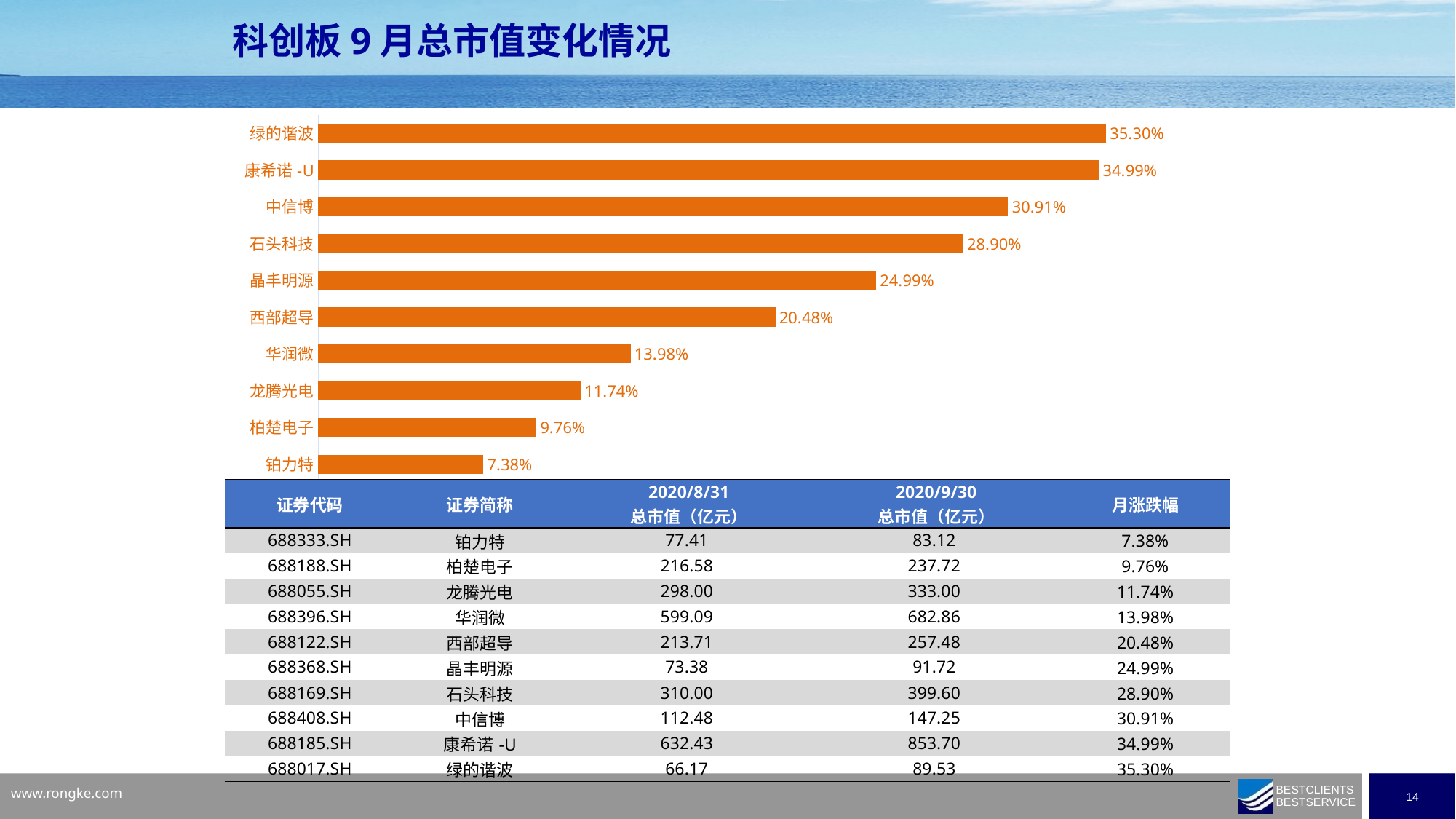
What colour are the bars in the chart? orange Which company has the lowest value in the bar chart? 铂力特 What is the value shown for 西部超导 in the bar chart? 20.48% What is the value shown for 绿的谐波 in the bar chart? 35.30% How many companies are plotted in the bar chart? 10 Which company has the highest value in the bar chart? 绿的谐波 What is the difference between the values for 晶丰明源 and 柏楚电子 in the bar chart? 15.23% What is the value shown for 康希诺-U in the bar chart? 34.99% What is the value shown for 铂力特 in the bar chart? 7.38% Which has a larger value in the bar chart, 华润微 or 龙腾光电? 华润微 What is the difference between the values for 中信博 and 石头科技 in the bar chart? 2.01% What kind of chart is shown on the slide? bar chart